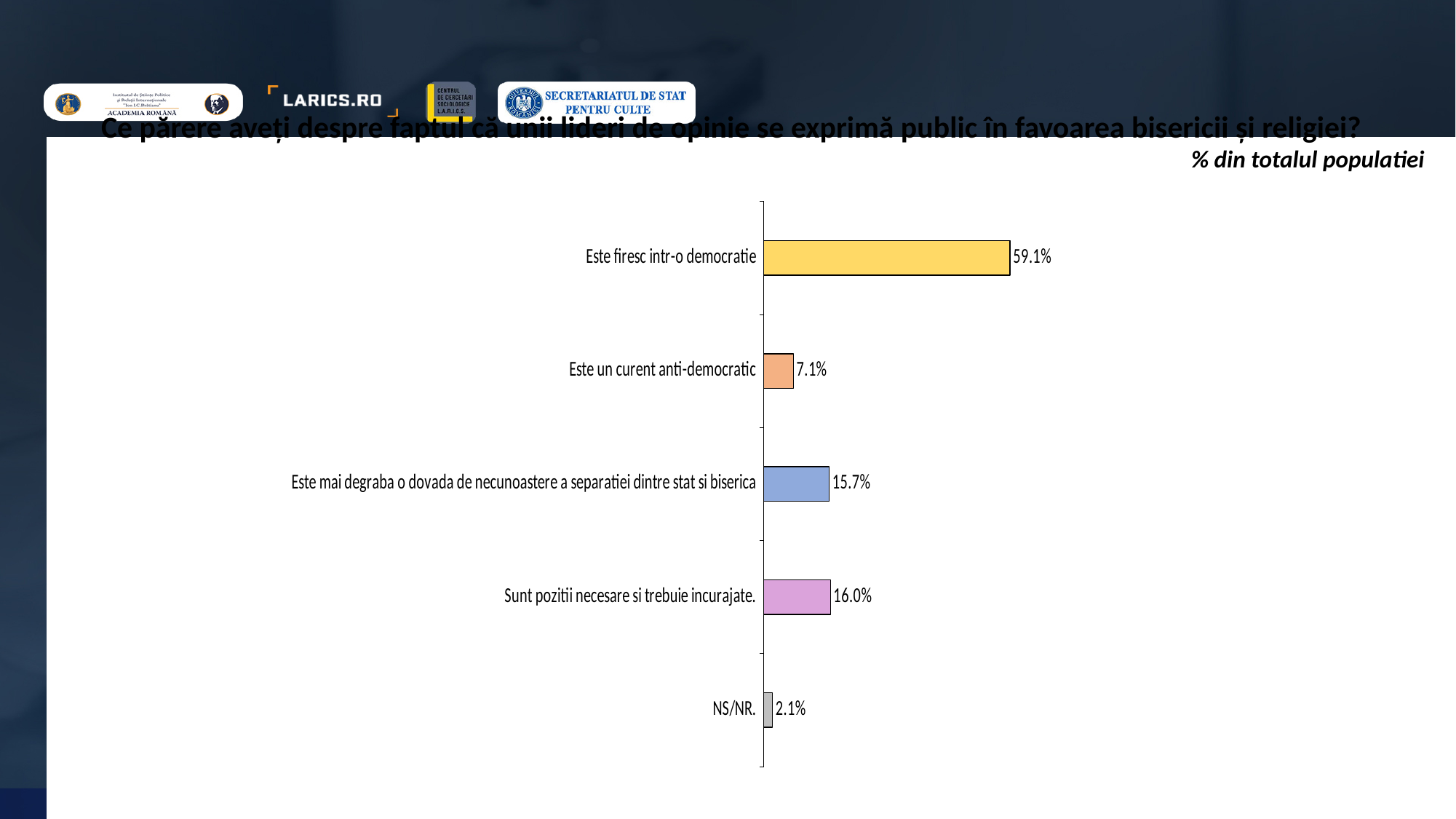
Which category has the lowest value? NS/NR. Which is larger: "Este un curent anti-democratic" or "Este mai degraba o dovada de necunoastere a separatiei dintre stat si biserica"? Este mai degraba o dovada de necunoastere a separatiei dintre stat si biserica Which category has the highest value? Este firesc intr-o democratie What is the difference between "Este firesc intr-o democratie" and "Este un curent anti-democratic"? 52.0% What is the value for "Sunt pozitii necesare si trebuie incurajate."? 16.0% What kind of chart is shown on the slide? Bar chart What is the value for "NS/NR."? 2.1% What unit note is shown above the chart on the right? % din totalul populatiei What is the value for "Este firesc intr-o democratie"? 59.1% How many categories are shown in the chart? 5 What is the value for "Este un curent anti-democratic"? 7.1% What is the difference between "Sunt pozitii necesare si trebuie incurajate." and "Este mai degraba o dovada de necunoastere a separatiei dintre stat si biserica"? 0.3%